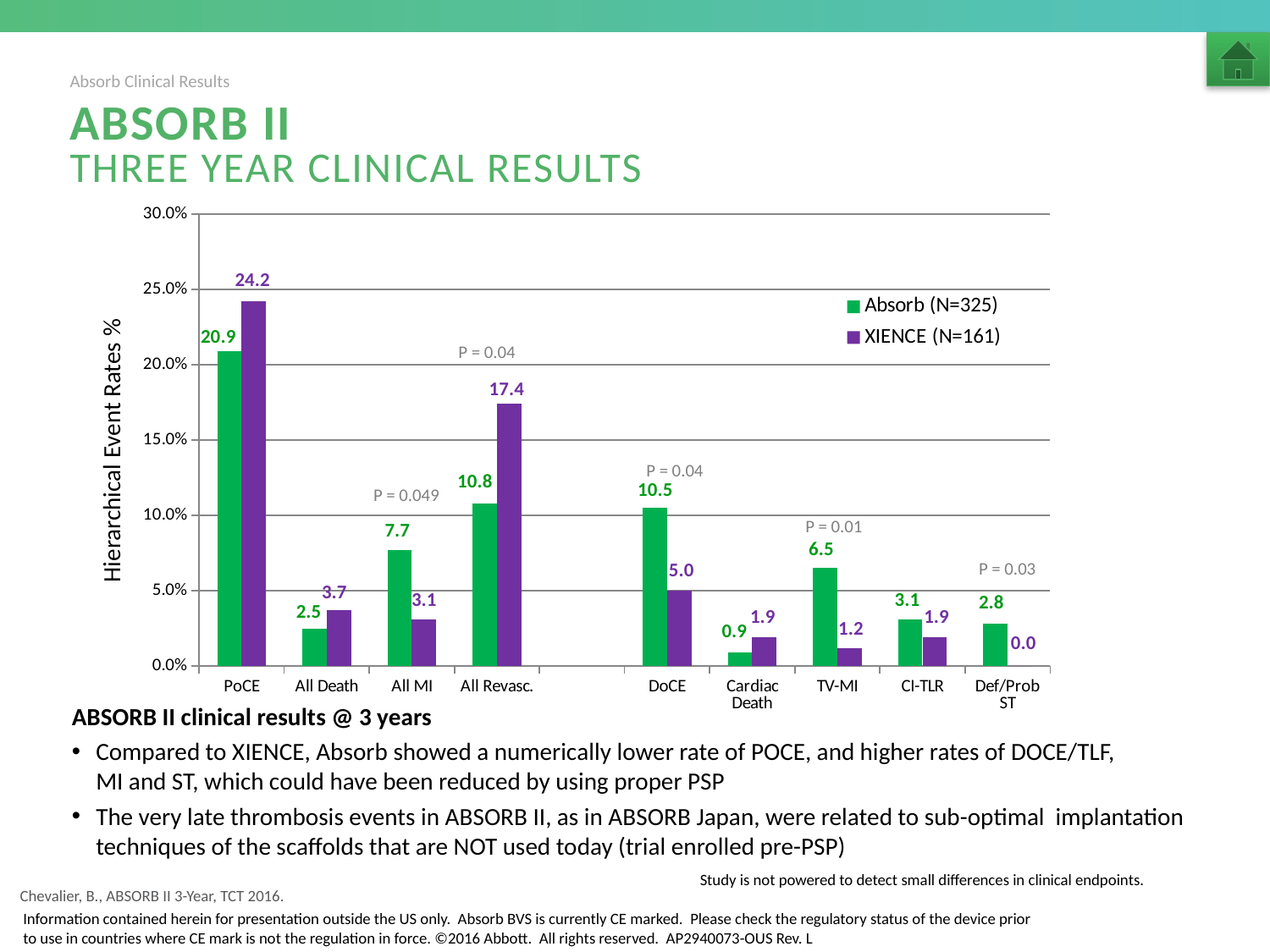
What is the difference between the Absorb (N=325) and XIENCE (N=161) values for TV-MI? 5.3 Which category has the lowest value for XIENCE (N=161)? Def/Prob ST What kind of chart is shown on the slide? Bar chart What is the y-axis label of the chart? Hierarchical Event Rates % How many categories are shown on the x axis? 9 What is the difference between the XIENCE (N=161) and Absorb (N=325) values for All Revasc.? 6.6 How many series does the legend list? 2 What is the value for XIENCE (N=161) for Def/Prob ST? 0.0 What is the value for Absorb (N=325) for All MI? 7.7 Which category has the highest value for Absorb (N=325)? PoCE Which is larger for DoCE, the Absorb (N=325) value or the XIENCE (N=161) value? Absorb (N=325) What is the value for XIENCE (N=161) for PoCE? 24.2